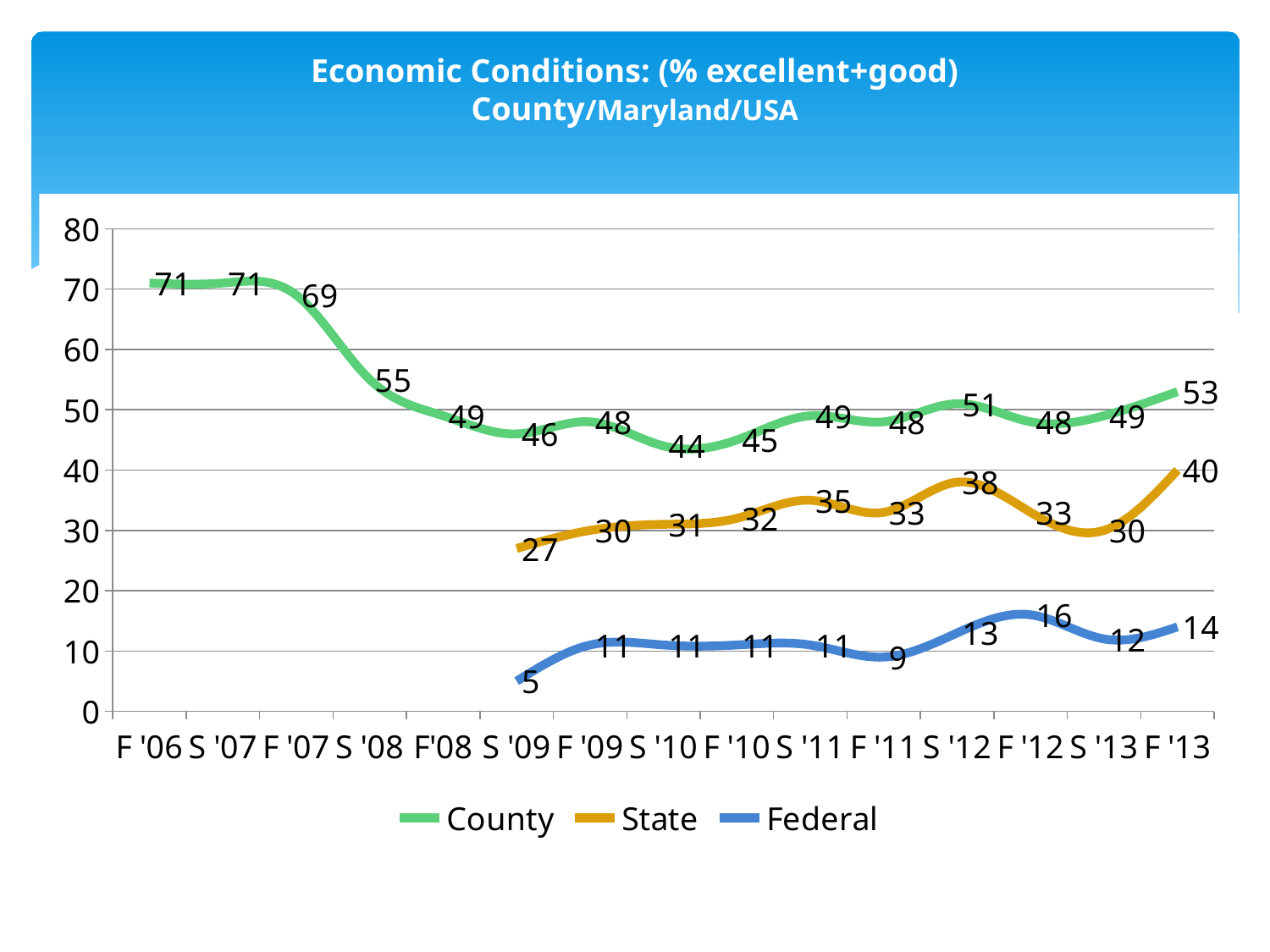
What is the State value for F '13? 40 How many time points are shown on the x axis? 15 At which time point is the County series lowest? S '10 At S '12, which is larger, the State value or the Federal value? State At which time point is the Federal series highest? F '12 At which time point is the State series highest? F '13 What is the difference between the County value for F '06 and the County value for F '13? 18 Does the County series rise or fall from F '06 to S '08? fall What kind of chart is shown on the slide? line chart What is the County value for F '06? 71 What is the Federal value for S '09? 5 How many series does the legend list? 3